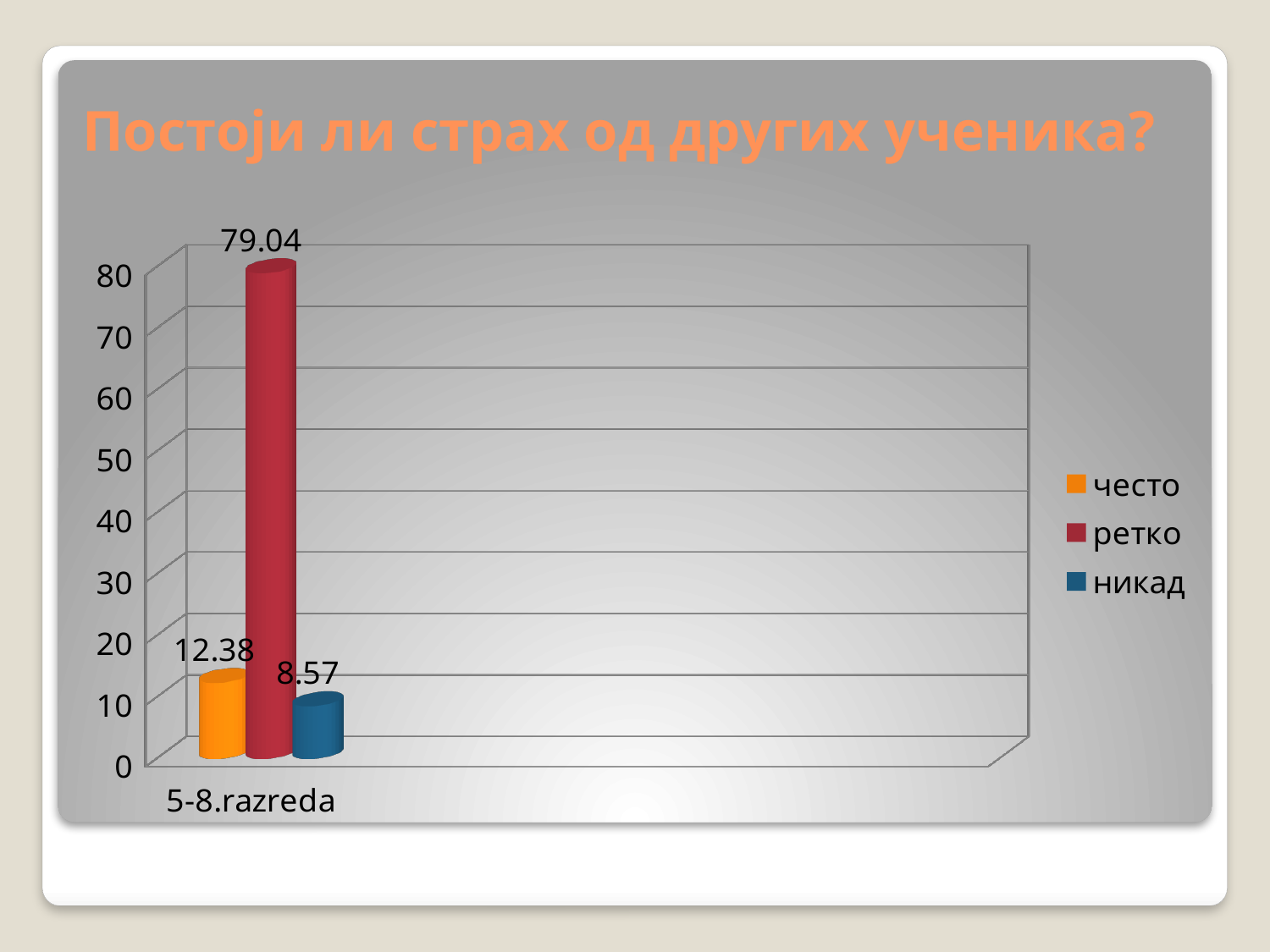
What kind of chart is shown on the slide? bar chart Is the value for "ретко" greater or less than 70? greater What is the difference between the values for "ретко" and "често"? 66.66 How many series does the legend list? 3 What is the value for the series "никад" for the category "5-8.razreda"? 8.57 What is the value for the series "ретко" for the category "5-8.razreda"? 79.04 Which series has the lowest value? никад Which is larger, the value for "често" or the value for "никад"? често What is the value for the series "често" for the category "5-8.razreda"? 12.38 Which series has the highest value? ретко What is the title of the chart? Постоји ли страх од других ученика? What is the difference between the values for "често" and "никад"? 3.81